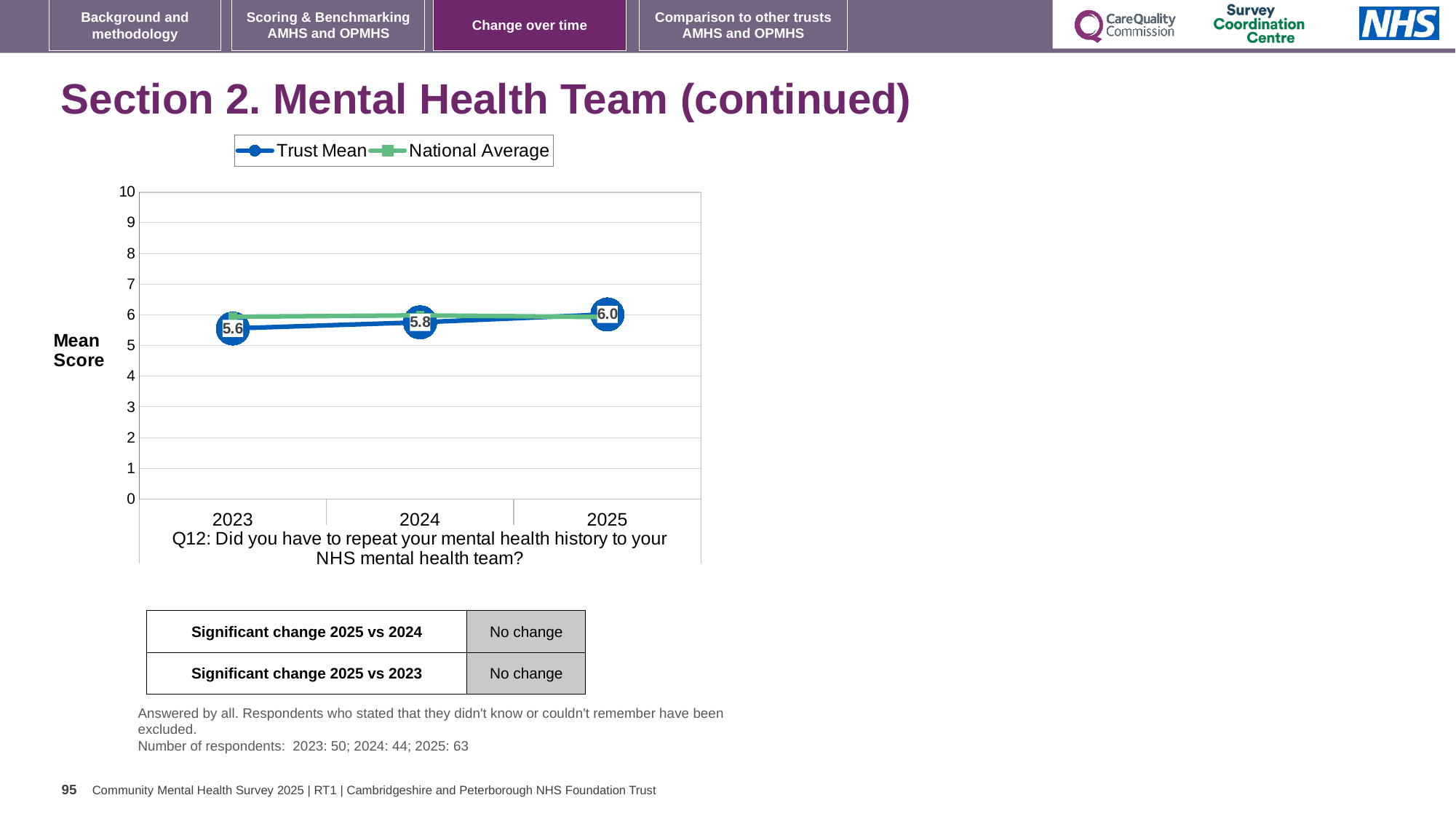
In which year is the Trust Mean highest? 2025 What is the difference between the Trust Mean in 2025 and in 2023? 0.4 What kind of chart is shown on the slide? Line chart What is the Trust Mean score for 2025? 6.0 Is the National Average value for 2023 greater or less than 5? greater Does the Trust Mean rise or fall from 2023 to 2025? Rise What is the Trust Mean score for 2023? 5.6 Which is larger, the Trust Mean in 2024 or in 2025? 2025 In which year is the Trust Mean lowest? 2023 How many series does the legend list? 2 What is the Trust Mean score for 2024? 5.8 How many years are plotted on the x axis? 3